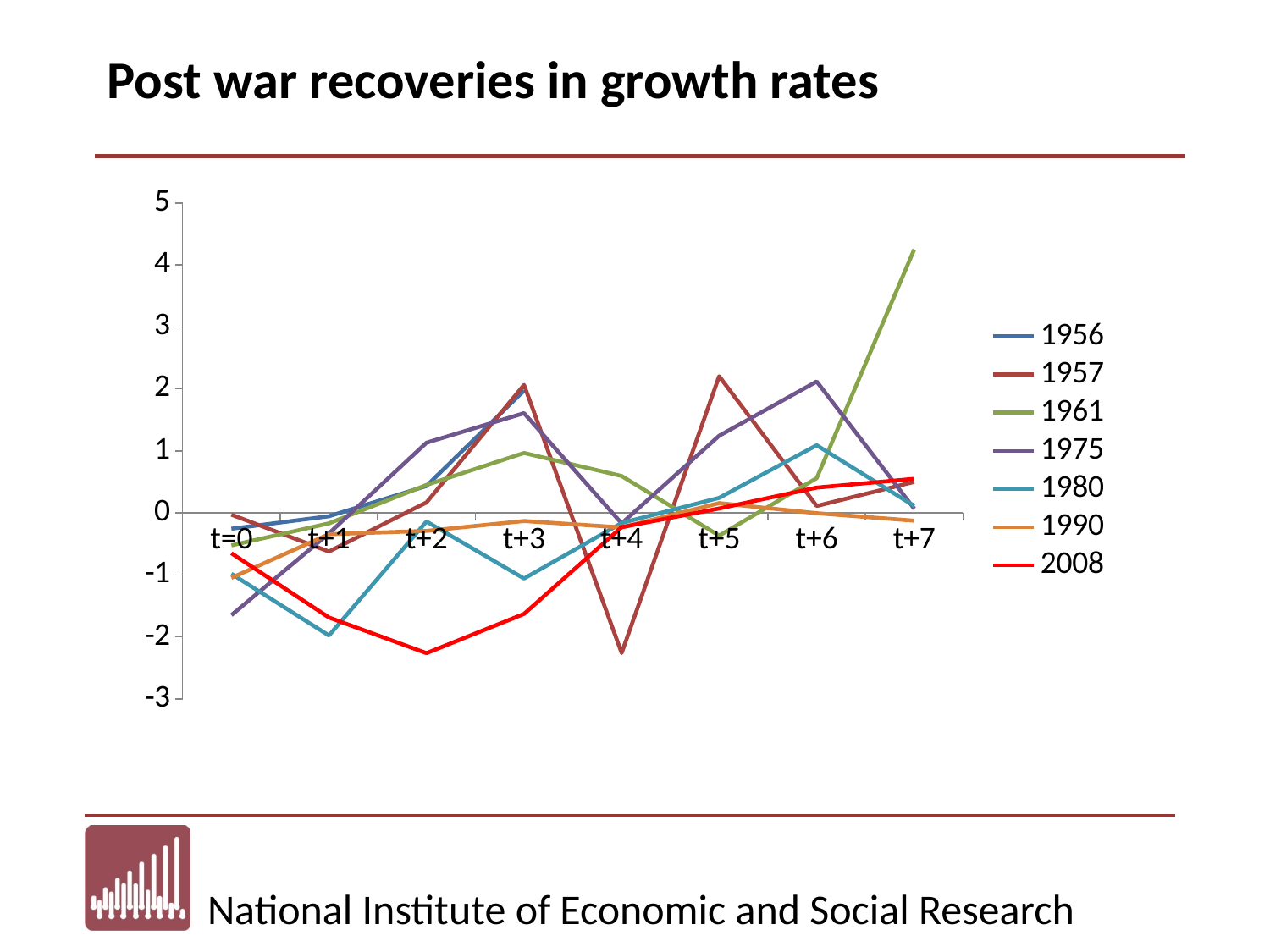
Is the value for 1961 at t+7 greater or less than 4? greater Is the value for 1980 at t+1 greater or less than -1? less Does the 2008 series rise or fall from t+2 to t+7? rise Which series has the lowest value at t+2? 2008 Which series has the lowest value at t=0? 1975 How many series does the legend list? 7 Which series has the lowest value at t+4? 1957 Is the value for 2008 at t+2 greater or less than -2? less How many points are there along the x axis (from t=0 to t+7)? 8 Which series reaches the highest value anywhere on the chart? 1961 At t+3, which series has the higher value, 1957 or 1980? 1957 What kind of chart is shown on the slide? line chart